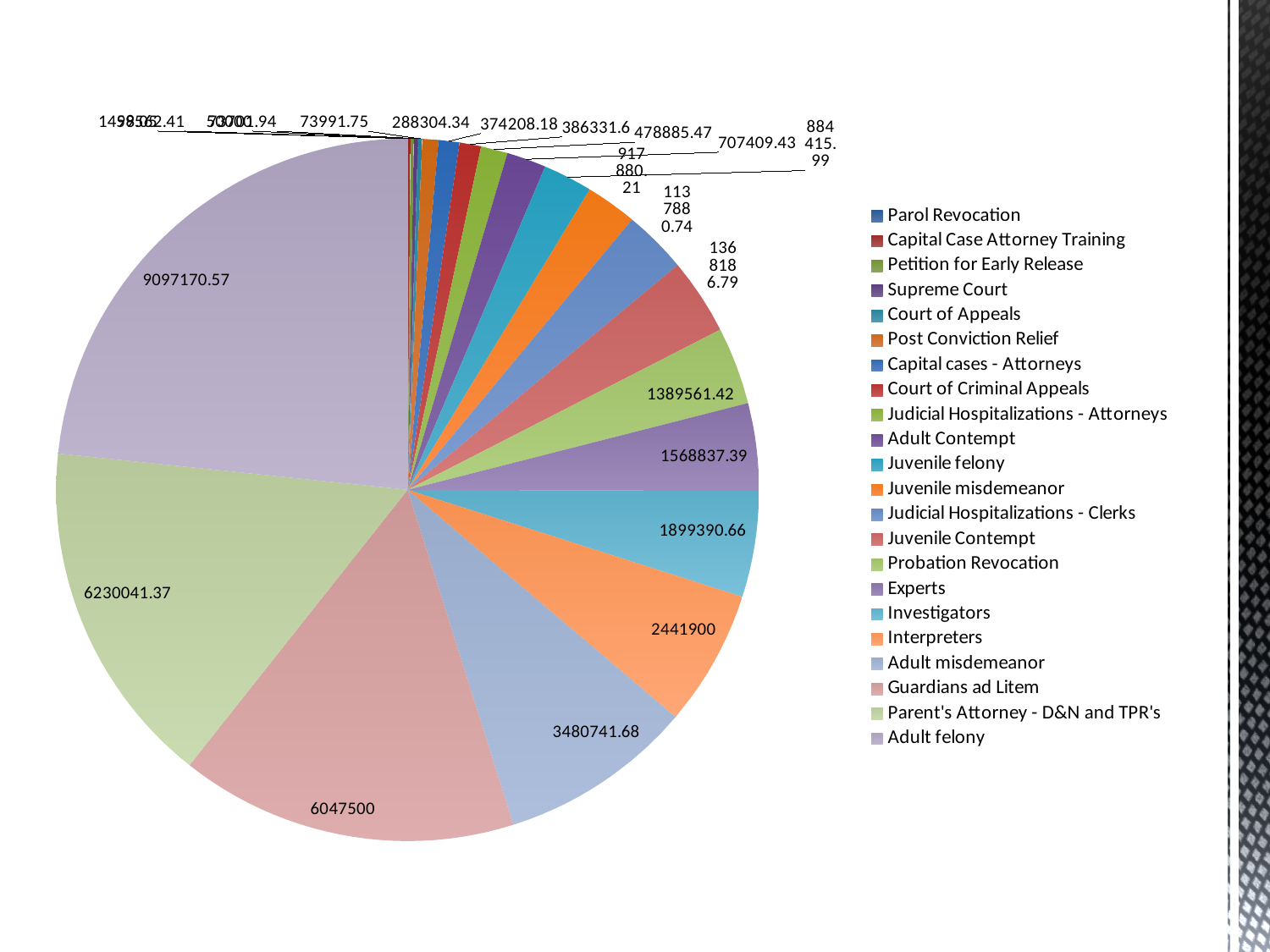
What is the difference between the values for Adult felony and Parent's Attorney - D&N and TPR's? 2867129.20 What kind of chart is shown on the slide? Pie chart Which is larger, the value for Experts or the value for Probation Revocation? Experts What is the value shown for Adult felony? 9097170.57 What is the value shown for Parent's Attorney - D&N and TPR's? 6230041.37 What is the value shown for Interpreters? 2441900 What is the value shown for Guardians ad Litem? 6047500 What is the value shown for Adult misdemeanor? 3480741.68 Which category has the largest slice of the pie chart? Adult felony How many categories does the legend of the pie chart list? 22 What is the value shown for Investigators? 1899390.66 What is the difference between the values for Adult misdemeanor and Interpreters? 1038841.68